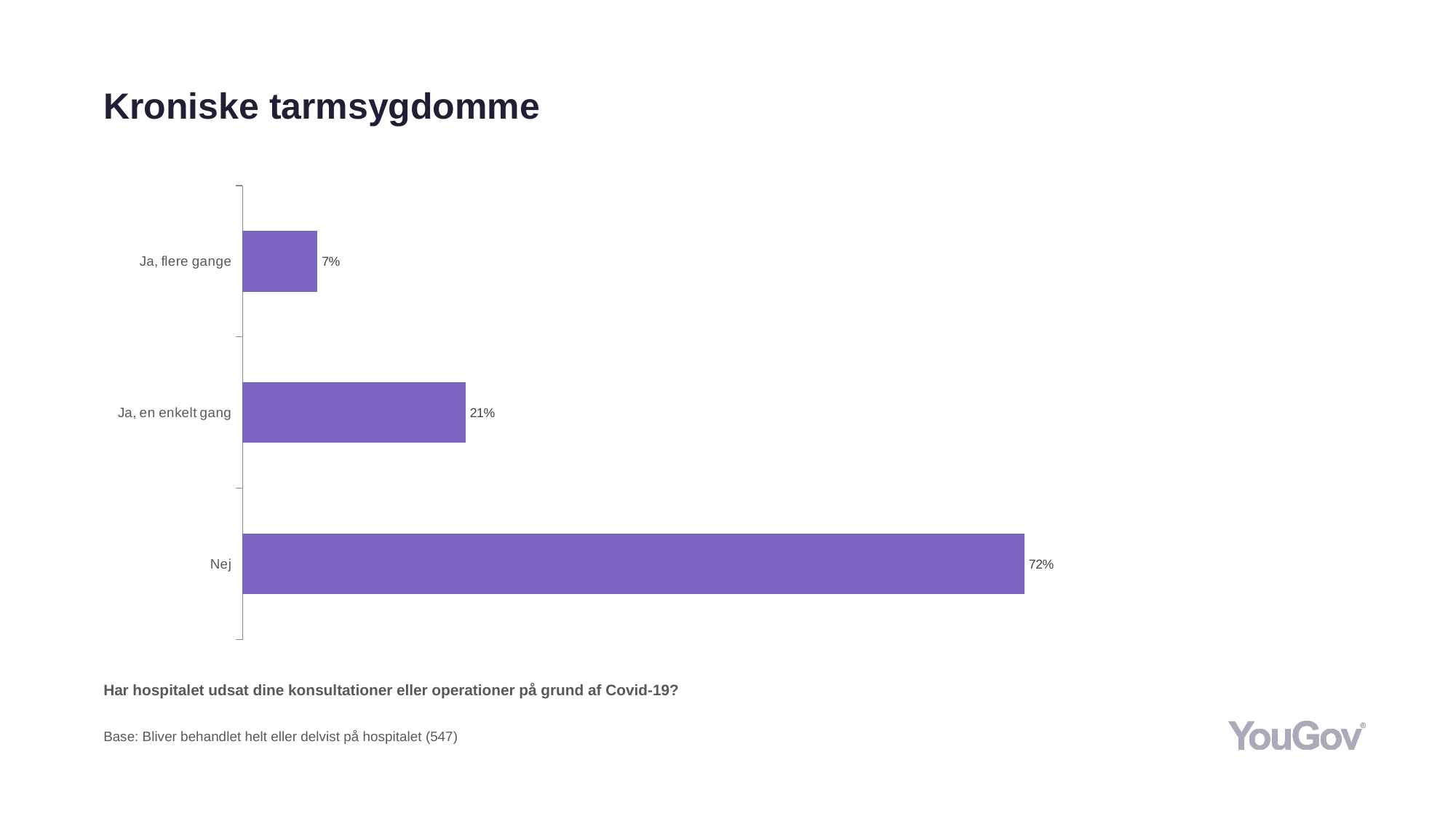
What is the title of the slide? Kroniske tarmsygdomme What is the value for "Ja, en enkelt gang"? 21% Which is larger, the value for "Ja, en enkelt gang" or the value for "Ja, flere gange"? Ja, en enkelt gang What is the difference between the values for "Ja, en enkelt gang" and "Ja, flere gange"? 14 percentage points What is the value for "Nej"? 72% Which category has the highest value? Nej What is the base size stated below the chart? 547 What is the value for "Ja, flere gange"? 7% What kind of chart is shown on the slide? Bar chart What is the difference between the values for "Nej" and "Ja, en enkelt gang"? 51 percentage points How many categories are shown in the chart? 3 Which category has the lowest value? Ja, flere gange